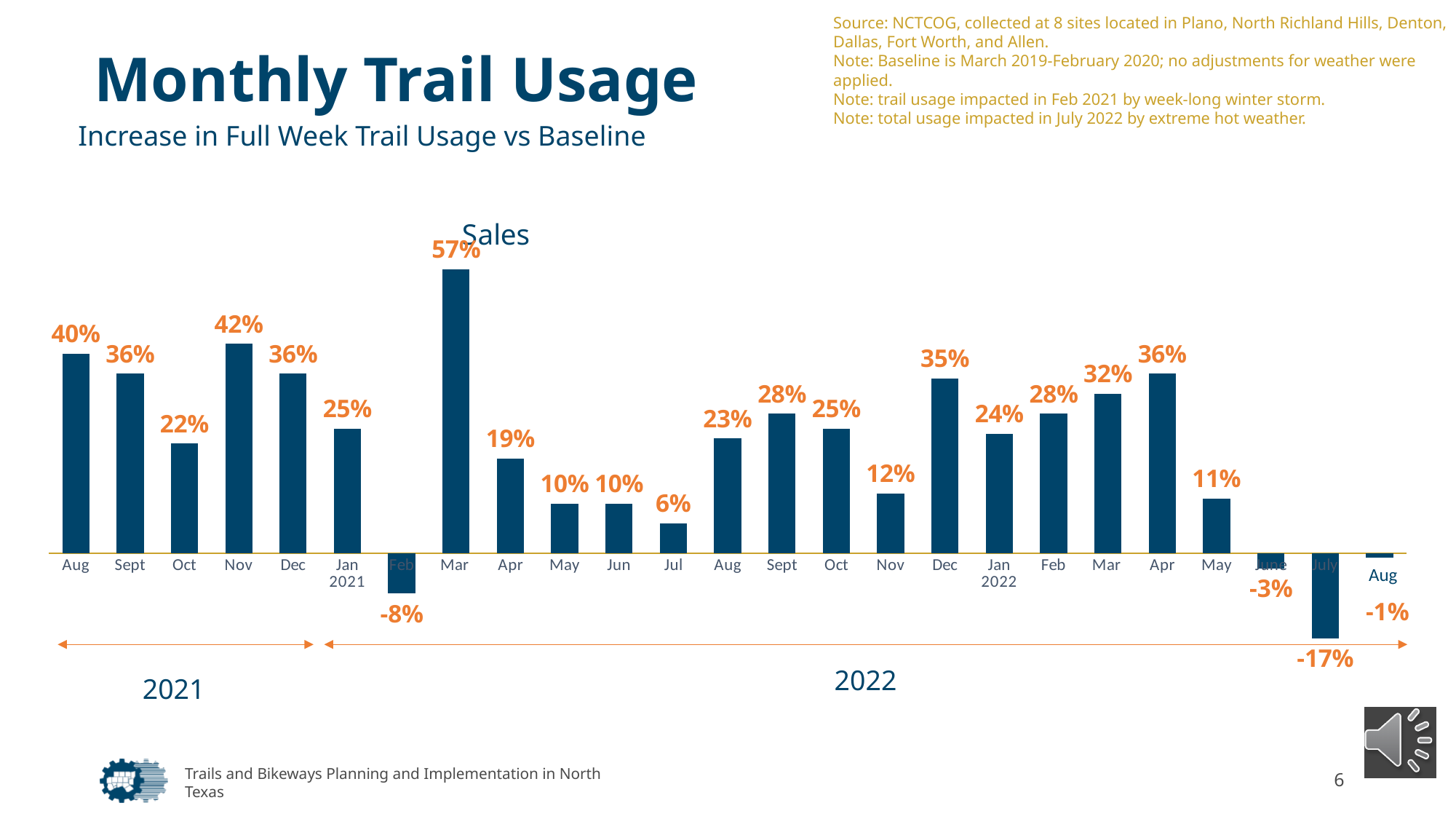
Which month has the highest value in the chart? Mar (after Jan 2021), 57% What is the value for the Feb bar immediately after Jan 2021? -8% What is the value for Jan 2021? 25% Which month has the lowest value in the chart? July (after Jan 2022), -17% What title is printed above the chart's plot area? Sales What type of chart is shown on the slide? bar chart What is the value for the July bar near the right end of the chart? -17% How many monthly bars are plotted in the chart? 25 What is the value for Jan 2022? 24% Which is larger, the value for Jan 2021 or the value for Jan 2022? Jan 2021 What is the difference between the value for Jan 2021 and the value for Jan 2022? 1 percentage point Do the values rise or fall from Jan 2022 through Apr 2022? rise